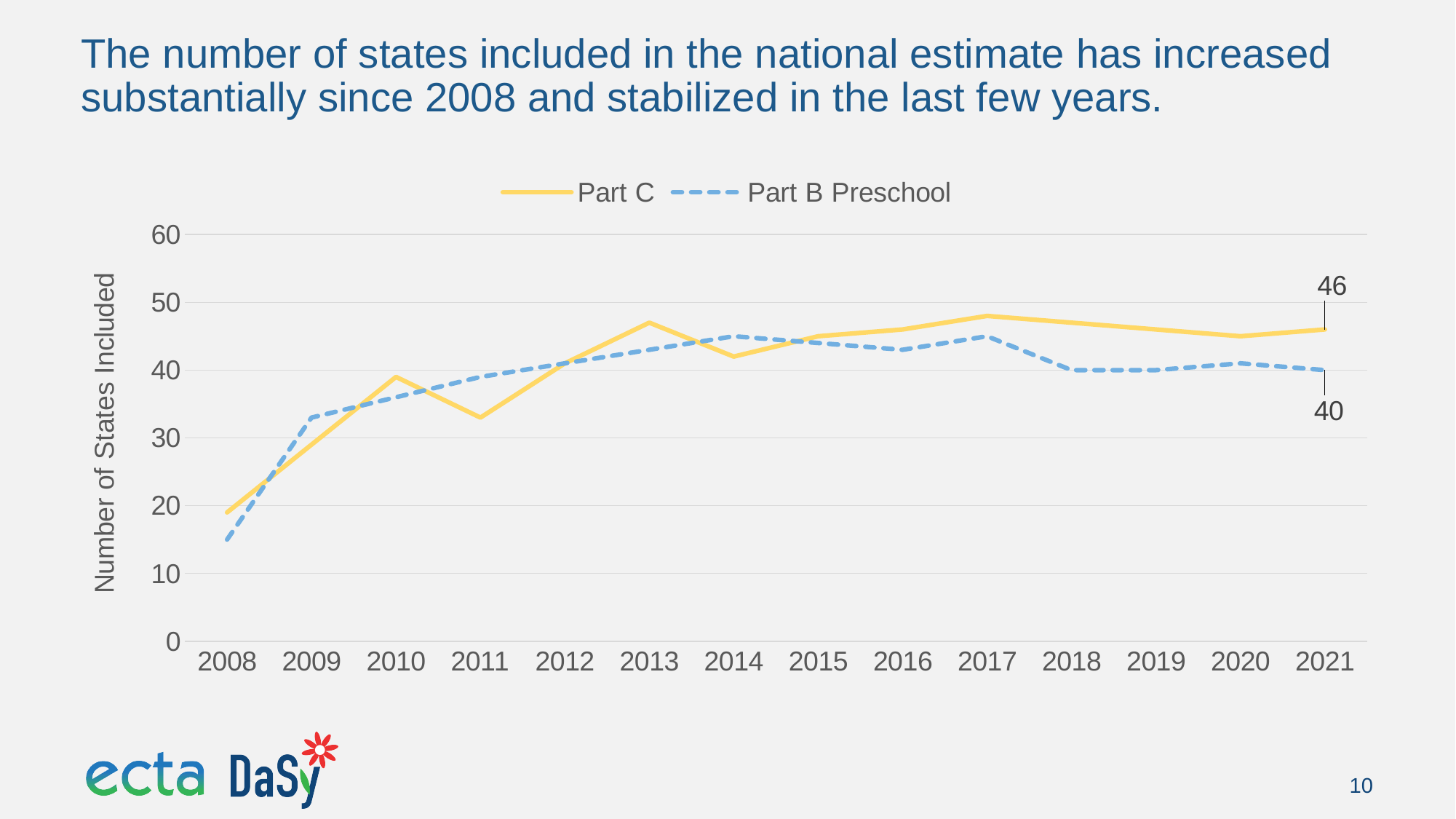
Is the value for Part C in 2011 greater or less than 30? greater In 2021, which series has the larger value, Part C or Part B Preschool? Part C How many years are shown on the x axis? 14 What is the difference between the Part C and Part B Preschool values in 2021? 6 Is the value for Part C in 2013 greater or less than 40? greater How many series does the legend list? 2 What is the value for Part C in 2021? 46 In which year is the Part C value lowest? 2008 Is the value for Part B Preschool in 2008 greater or less than 20? less In which year is the Part B Preschool value lowest? 2008 What is the value for Part B Preschool in 2021? 40 What kind of chart is shown on the slide? line chart